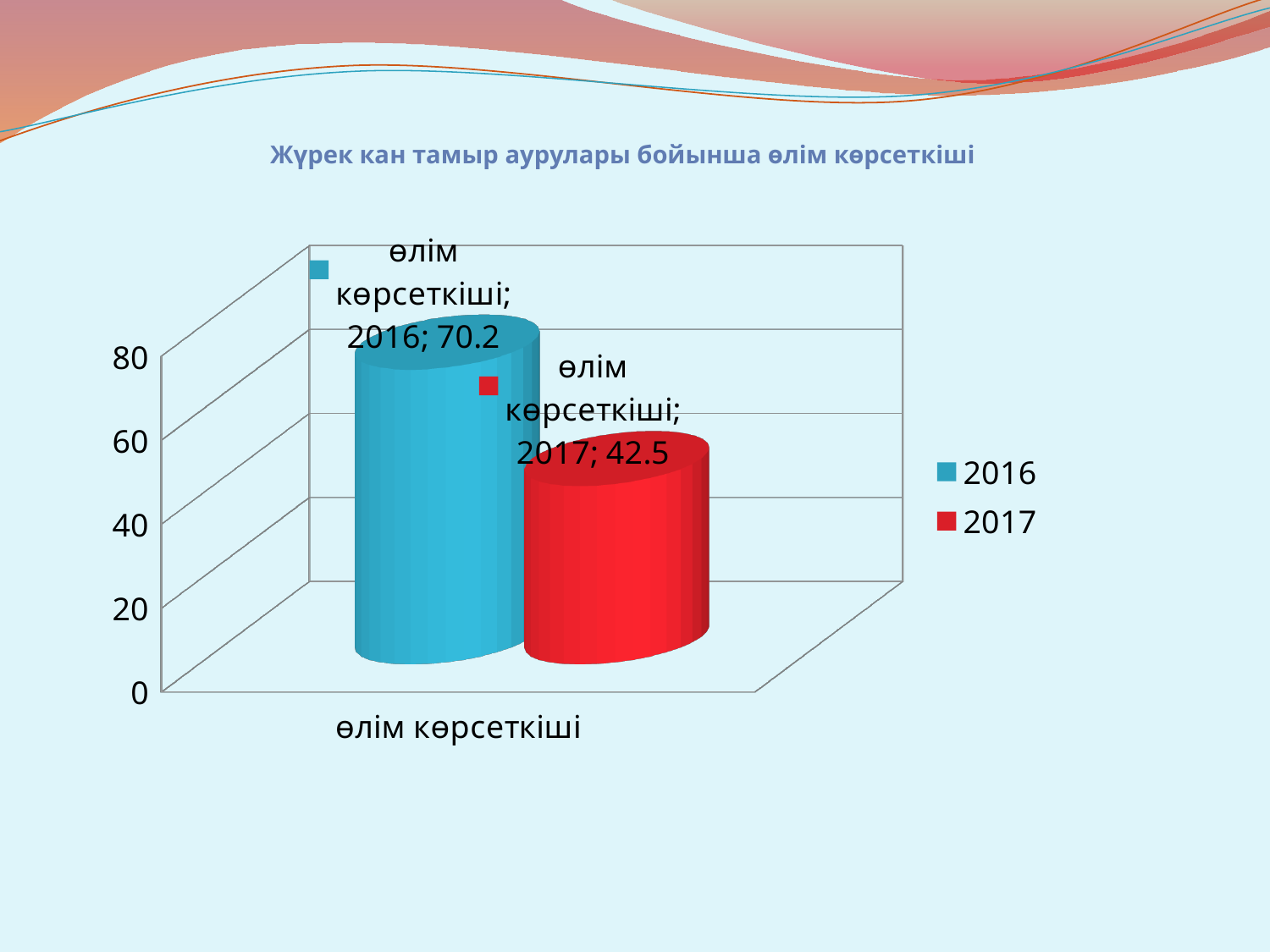
Is the value for 2017 greater or less than 60? less What is the value for 2016 in the chart? 70.2 What colour is the bar for 2017? red How many series does the legend list? 2 What is the difference between the 2016 and 2017 values? 27.7 What kind of chart is shown on the slide? bar chart What is the title of the chart on the slide? Жүрек кан тамыр аурулары бойынша өлім көрсеткіші Which series has the lowest value in the chart? 2017 What is the category label on the x axis? өлім көрсеткіші Which year has the higher value, 2016 or 2017? 2016 What is the value for 2017 in the chart? 42.5 Is the value for 2016 greater or less than 60? greater